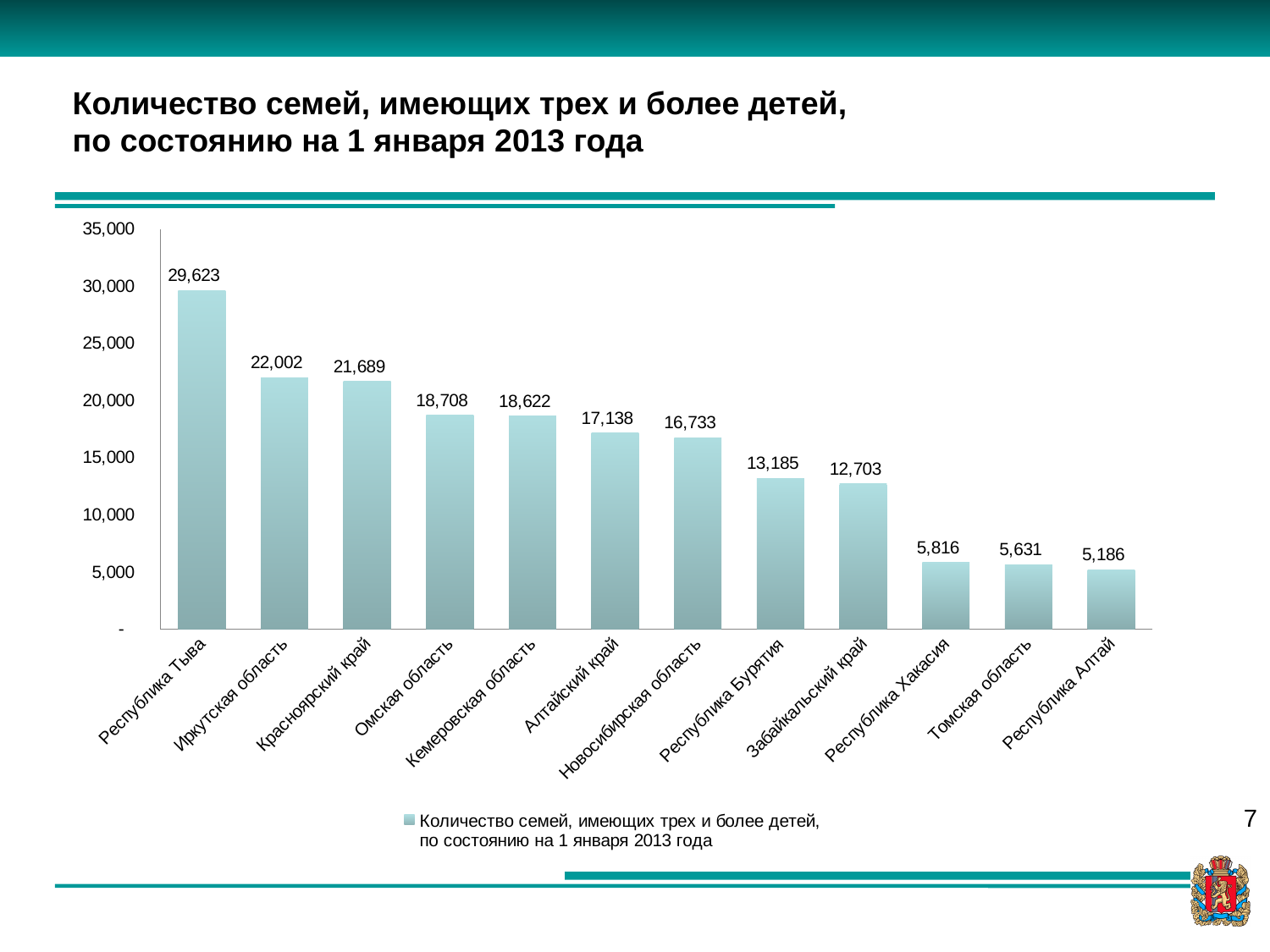
What is the value for Омская область? 18,708 Do the values rise or fall from left to right along the x axis? fall How many series does the legend list? 1 Is the value for Республика Бурятия greater or less than 15,000? less What kind of chart is shown on the slide? bar chart How many regions are shown on the chart? 12 Which region has the lowest value? Республика Алтай Which is larger, the value for Алтайский край or the value for Новосибирская область? Алтайский край What is the value for Республика Тыва? 29,623 What is the difference between the values for Иркутская область and Красноярский край? 313 What is the value for Республика Хакасия? 5,816 Which region has the highest value? Республика Тыва